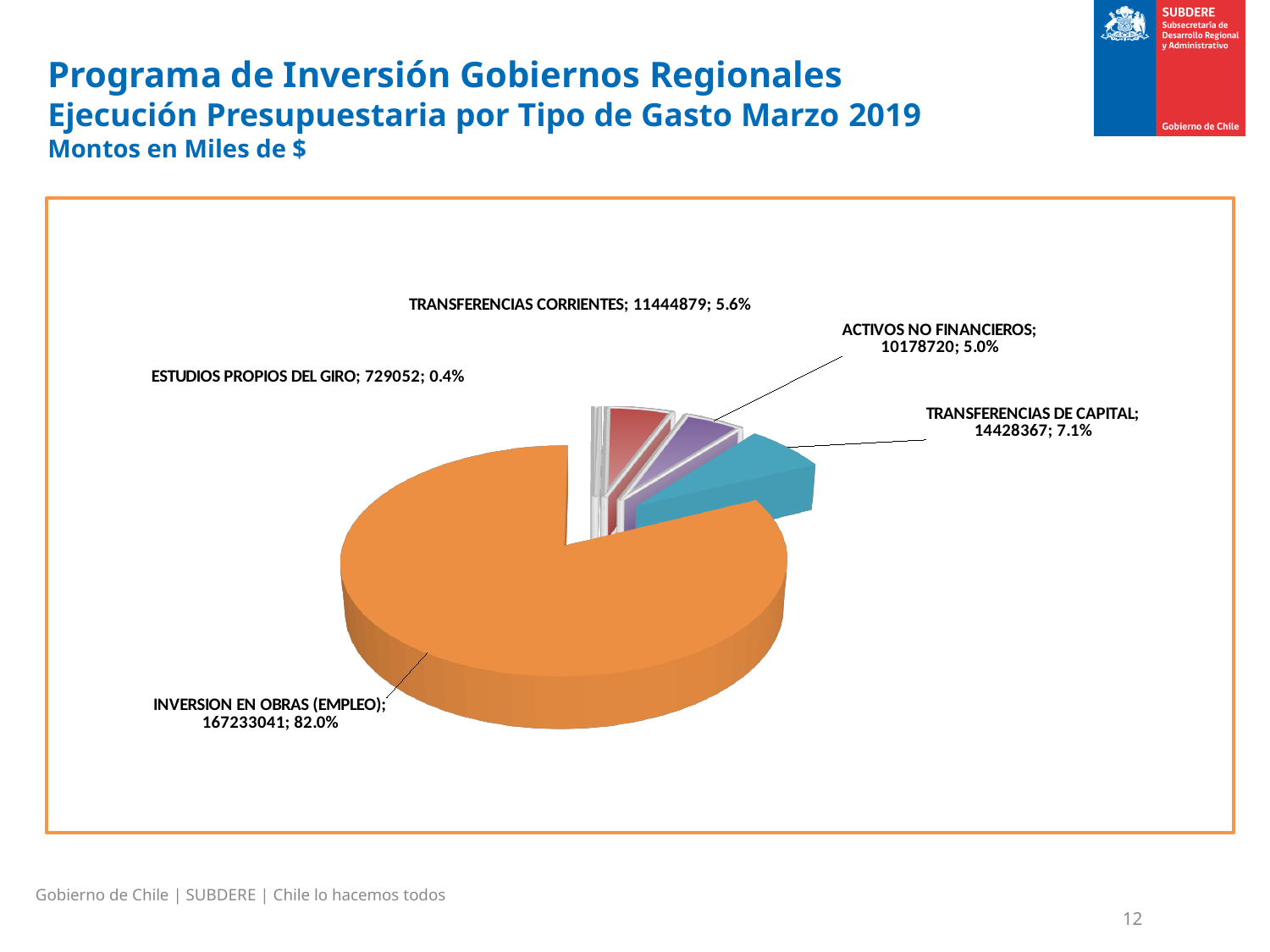
How many slices does the pie chart have? 5 Which category has the largest slice of the pie? INVERSION EN OBRAS (EMPLEO) What kind of chart is shown on the slide? Pie chart What share of the pie does TRANSFERENCIAS DE CAPITAL represent? 7.1% What is the value for ESTUDIOS PROPIOS DEL GIRO? 729052 What is the difference between the values for TRANSFERENCIAS DE CAPITAL and TRANSFERENCIAS CORRIENTES? 2983488 What share of the pie does TRANSFERENCIAS CORRIENTES represent? 5.6% Which category has the smallest slice of the pie? ESTUDIOS PROPIOS DEL GIRO What is the value for INVERSION EN OBRAS (EMPLEO)? 167233041 What share of the pie does ACTIVOS NO FINANCIEROS represent? 5.0% Which is larger, TRANSFERENCIAS CORRIENTES or ACTIVOS NO FINANCIEROS? TRANSFERENCIAS CORRIENTES What colour is the INVERSION EN OBRAS (EMPLEO) slice? Orange